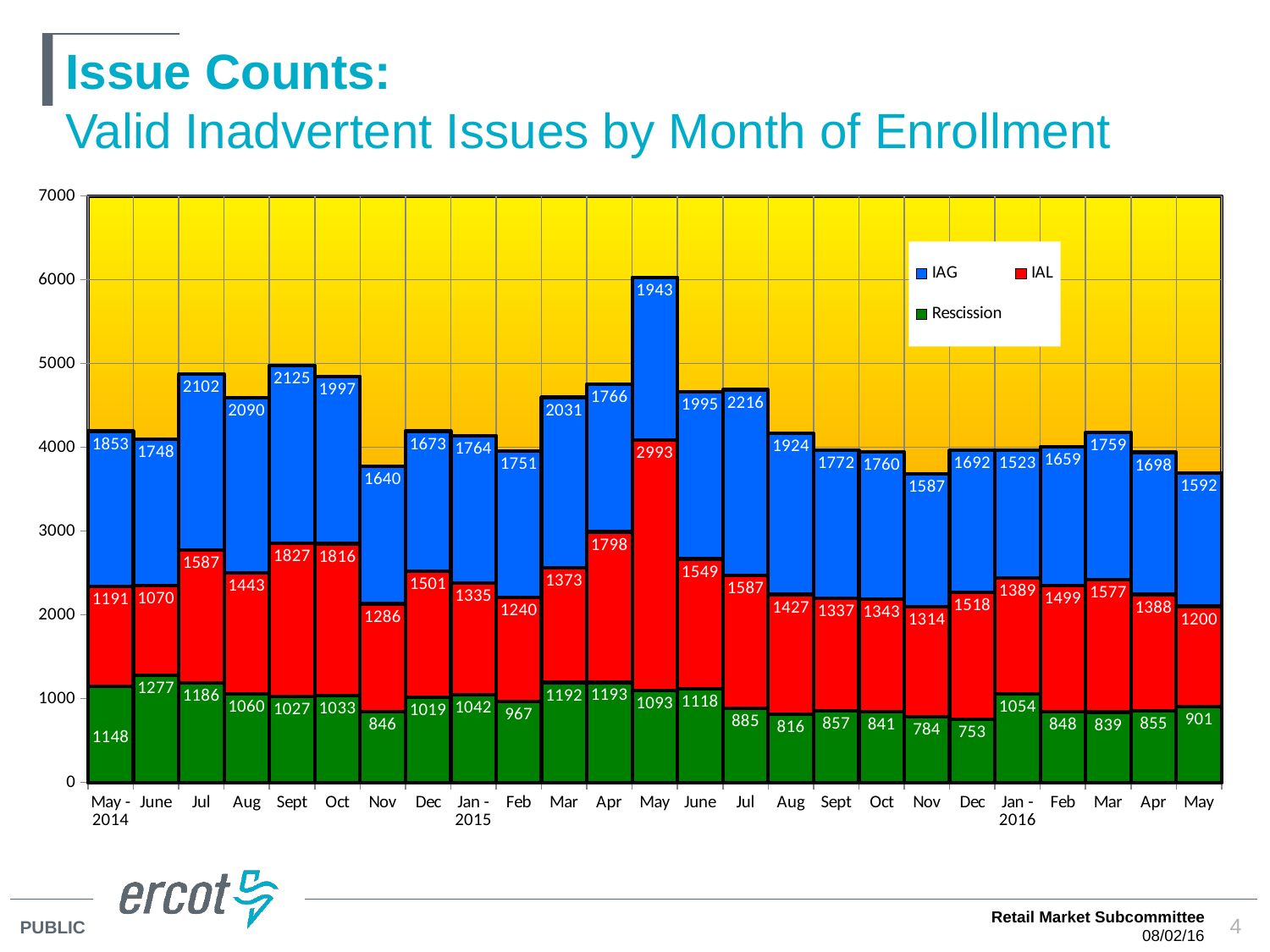
How many months are plotted on the x axis? 25 Which month has the highest IAG value? Jul 2015 What is the IAG value for Sept 2014? 2125 What is the difference between the IAG values for Jul 2014 and Nov 2014? 462 Which month has the lowest Rescission value? Dec 2015 Which is larger, the Rescission value for June 2014 or for May 2014? June 2014 What is the total of the stacked bar for May 2015? 6029 What is the IAL value for May 2015? 2993 What type of chart is shown on the slide? stacked bar chart Which month has the highest IAL value? May 2015 What is the Rescission value for Dec 2015? 753 How many series does the legend list? 3